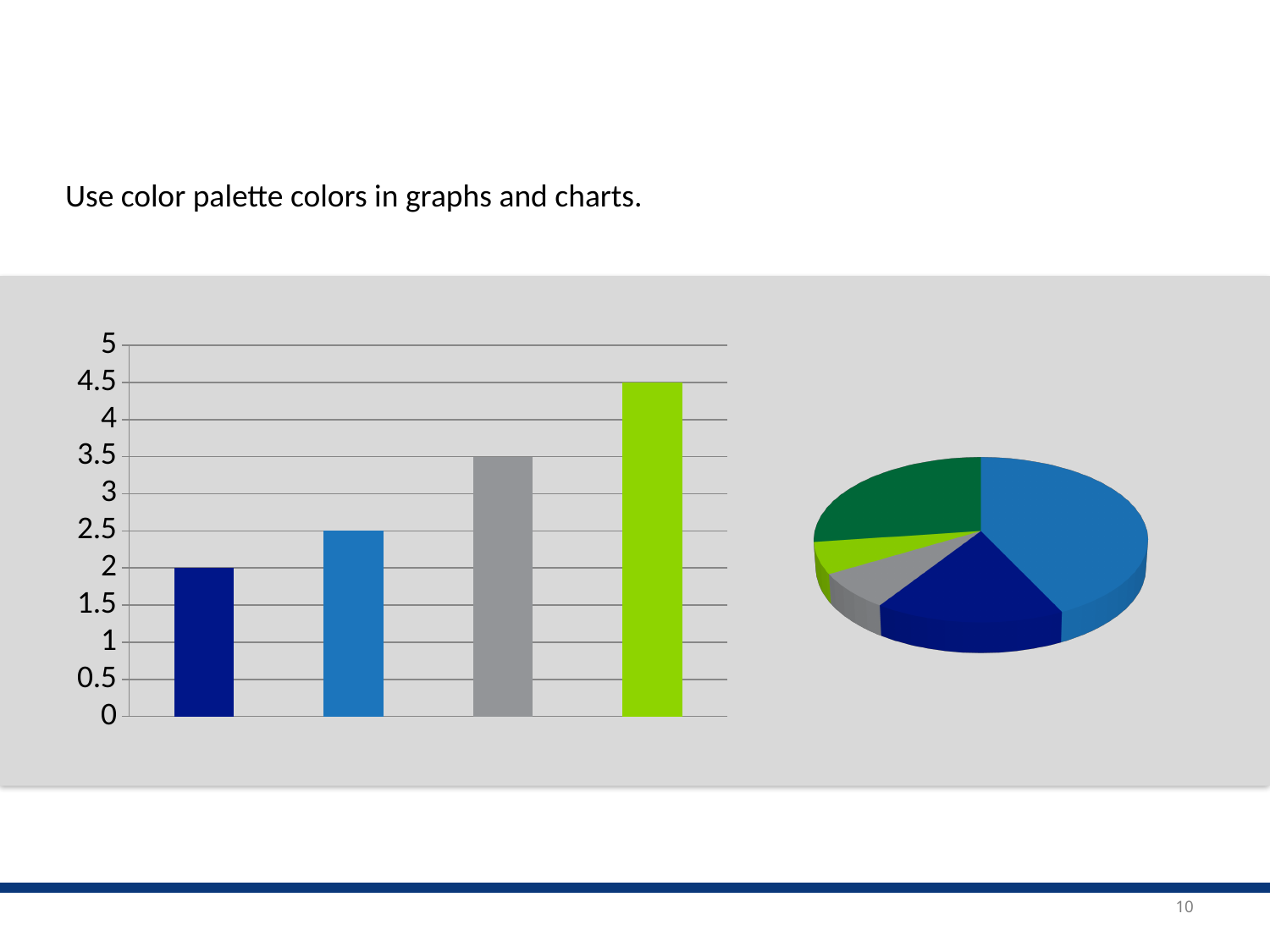
In the pie chart on the right, how many slices are there? 5 In the bar chart on the left, which bar is the tallest? the fourth (green) bar In the bar chart on the left, what is the value of the first (dark blue) bar? 2 In the bar chart on the left, what is the value of the third (grey) bar? 3.5 In the bar chart on the left, what is the value of the second (light blue) bar? 2.5 In the bar chart on the left, what is the value of the fourth (green) bar? 4.5 In the bar chart on the left, do the bar values rise or fall from left to right? rise In the bar chart on the left, what is the difference between the fourth (green) bar and the first (dark blue) bar? 2.5 In the bar chart on the left, how many bars are plotted? 4 What kind of chart is the chart on the left of the slide? bar chart What kind of chart is the chart on the right of the slide? pie chart In the pie chart on the right, which colour slice is the largest? light blue